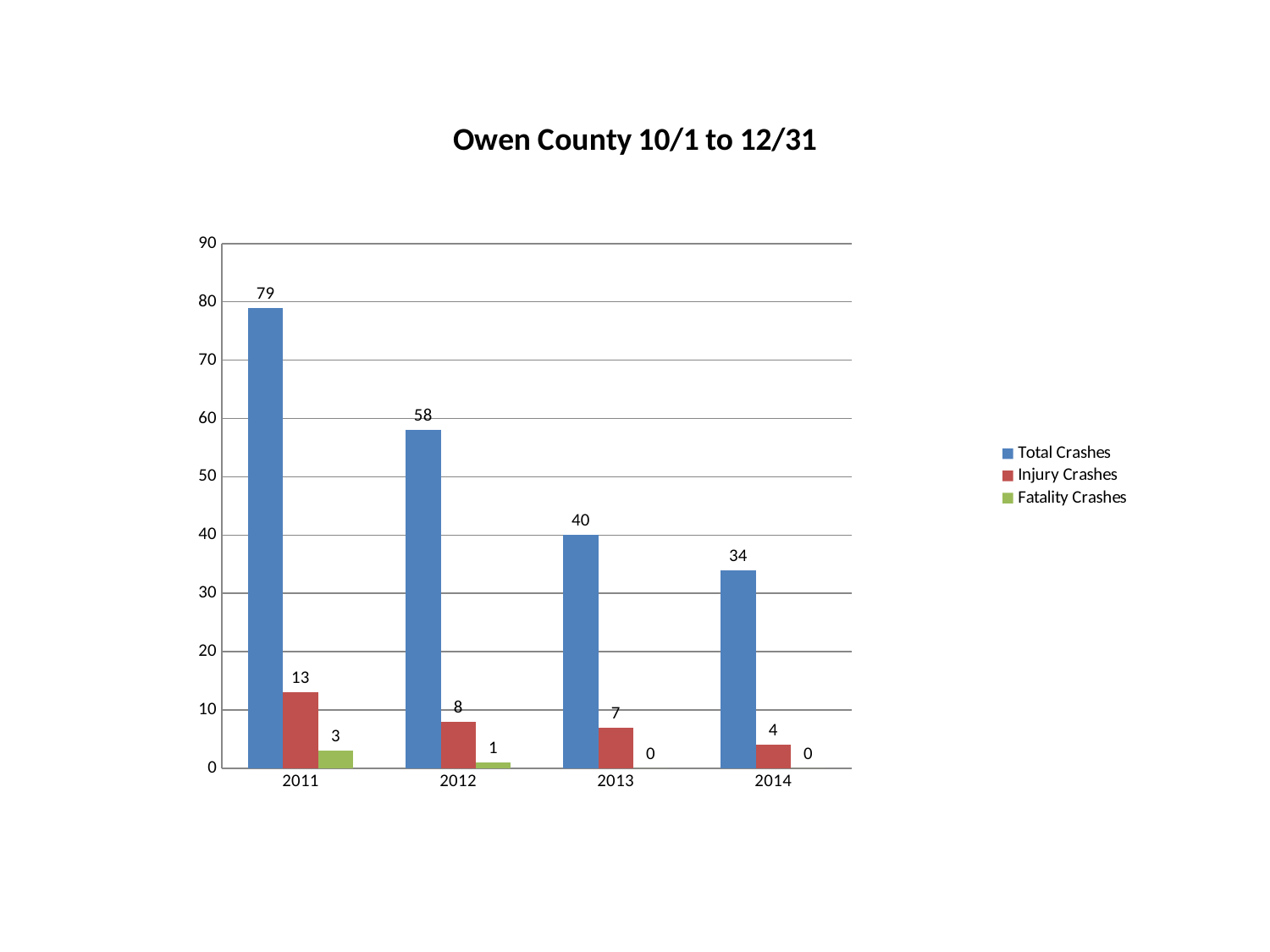
Which year has the highest value for Total Crashes? 2011 What is the difference between Total Crashes in 2011 and Total Crashes in 2014? 45 What kind of chart is shown on the slide? Bar chart How many years are shown on the x axis? 4 What is the title of the chart? Owen County 10/1 to 12/31 What is the value for Total Crashes in 2011? 79 What is the value for Injury Crashes in 2013? 7 Which year has the lowest value for Injury Crashes? 2014 Which is larger: Injury Crashes in 2012 or Injury Crashes in 2013? Injury Crashes in 2012 What is the value for Fatality Crashes in 2012? 1 Do the Total Crashes values rise or fall from 2011 to 2014? Fall How many series does the legend list? 3